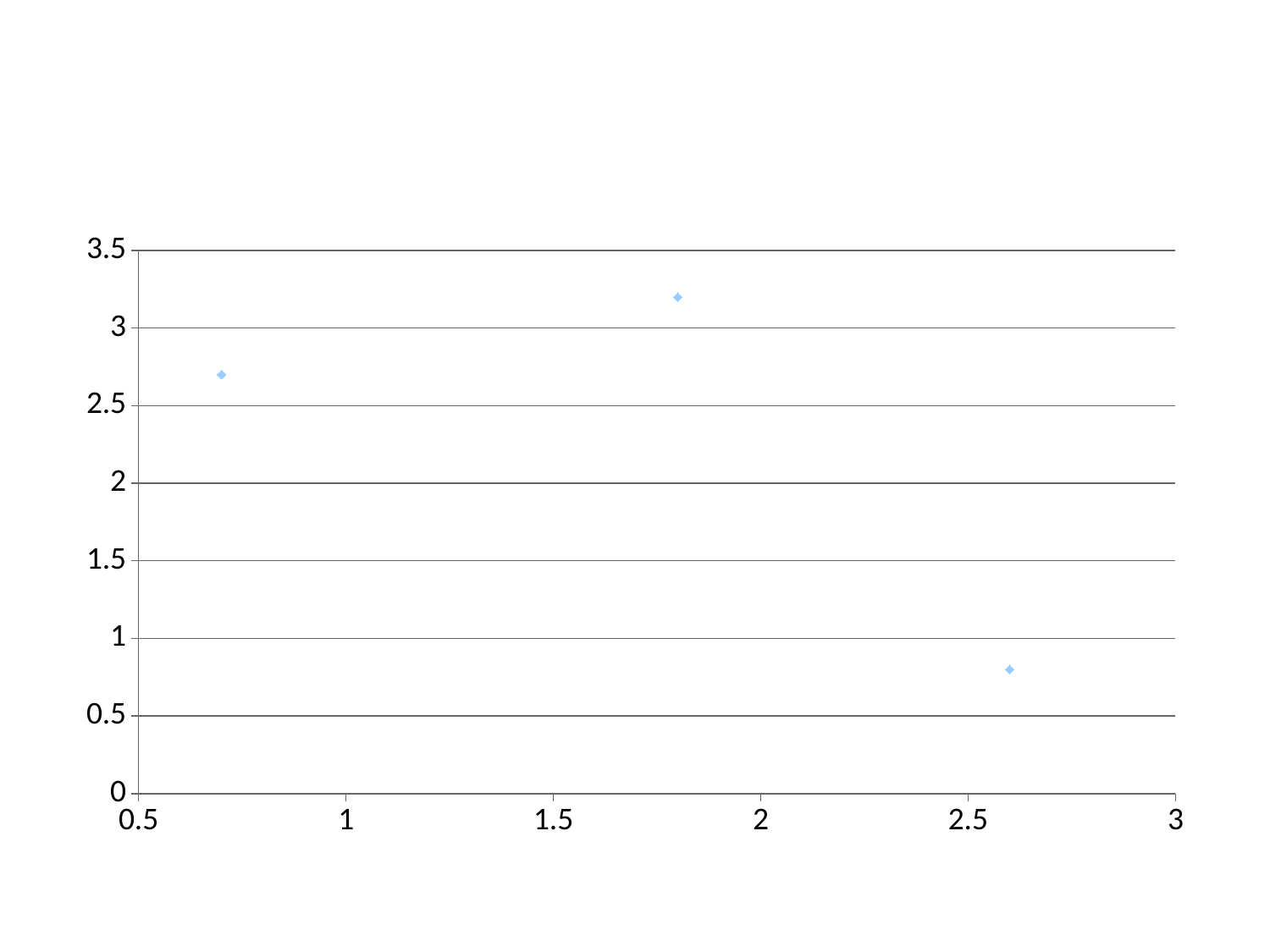
Is the x value of the rightmost point greater or less than 2.5? greater Which has the larger y value, the leftmost point or the rightmost point? the leftmost point Which point has the lowest y value: the leftmost, the middle, or the rightmost? the rightmost How many data points are plotted on the chart? 3 What kind of chart is shown on the slide? scatter chart What is the lowest value shown on the x axis? 0.5 Is the y value of the leftmost point greater or less than 2.5? greater Is the y value of the rightmost point greater or less than 1? less What is the highest value shown on the y axis? 3.5 Which point has the highest y value: the leftmost, the middle, or the rightmost? the middle